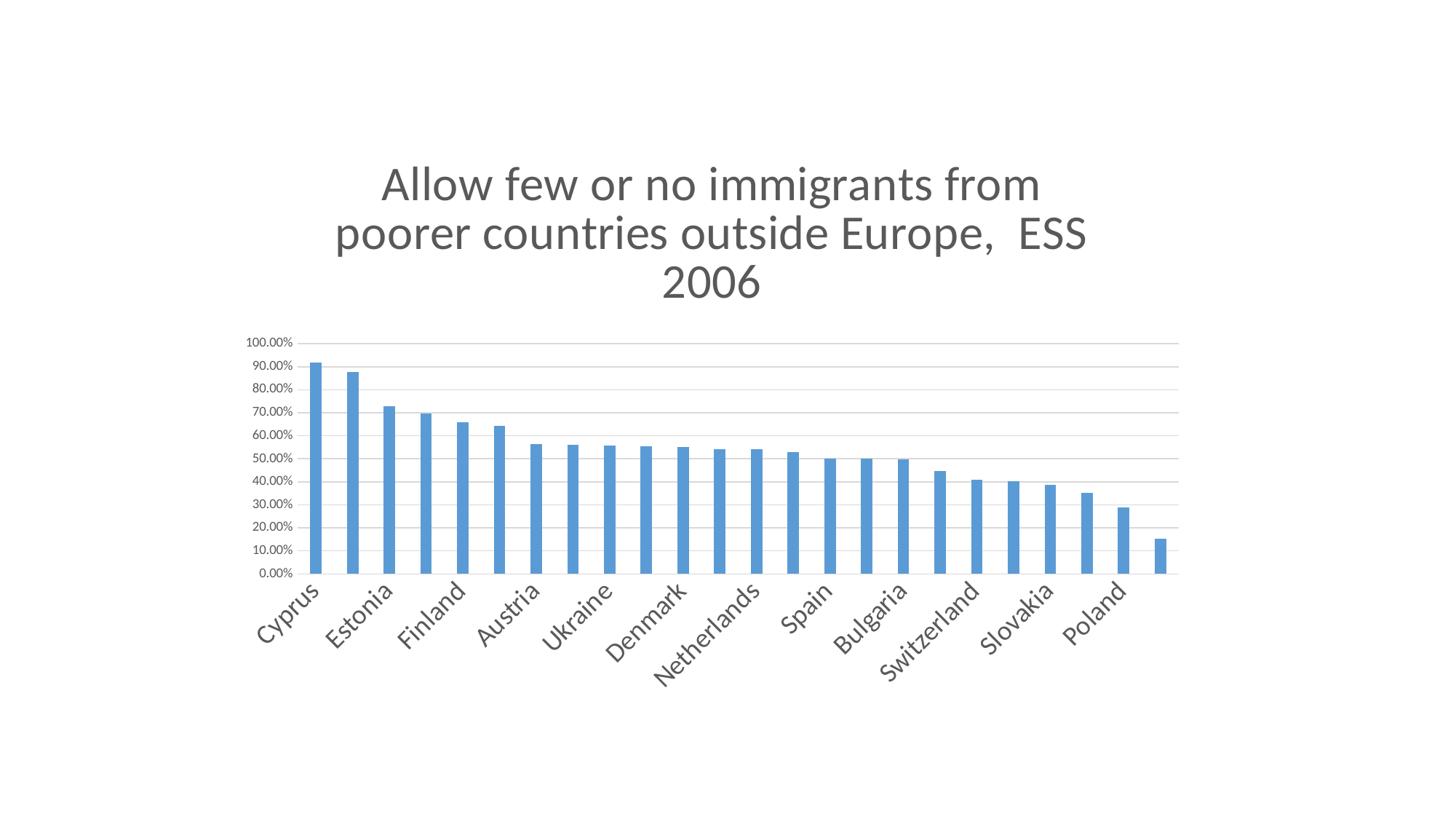
What is the title of the chart? Allow few or no immigrants from poorer countries outside Europe, ESS 2006 What kind of chart is shown on the slide? bar chart Is the value for Cyprus greater or less than 80.00%? greater Is the value for Poland greater or less than 40.00%? less How many country labels are shown on the x axis? 12 Which labelled country has the lowest value? Poland Is the value for Finland greater or less than 60.00%? greater Do the values generally rise or fall from left to right along the x axis? fall Which has a larger value, Estonia or Slovakia? Estonia Which labelled country has the highest value? Cyprus